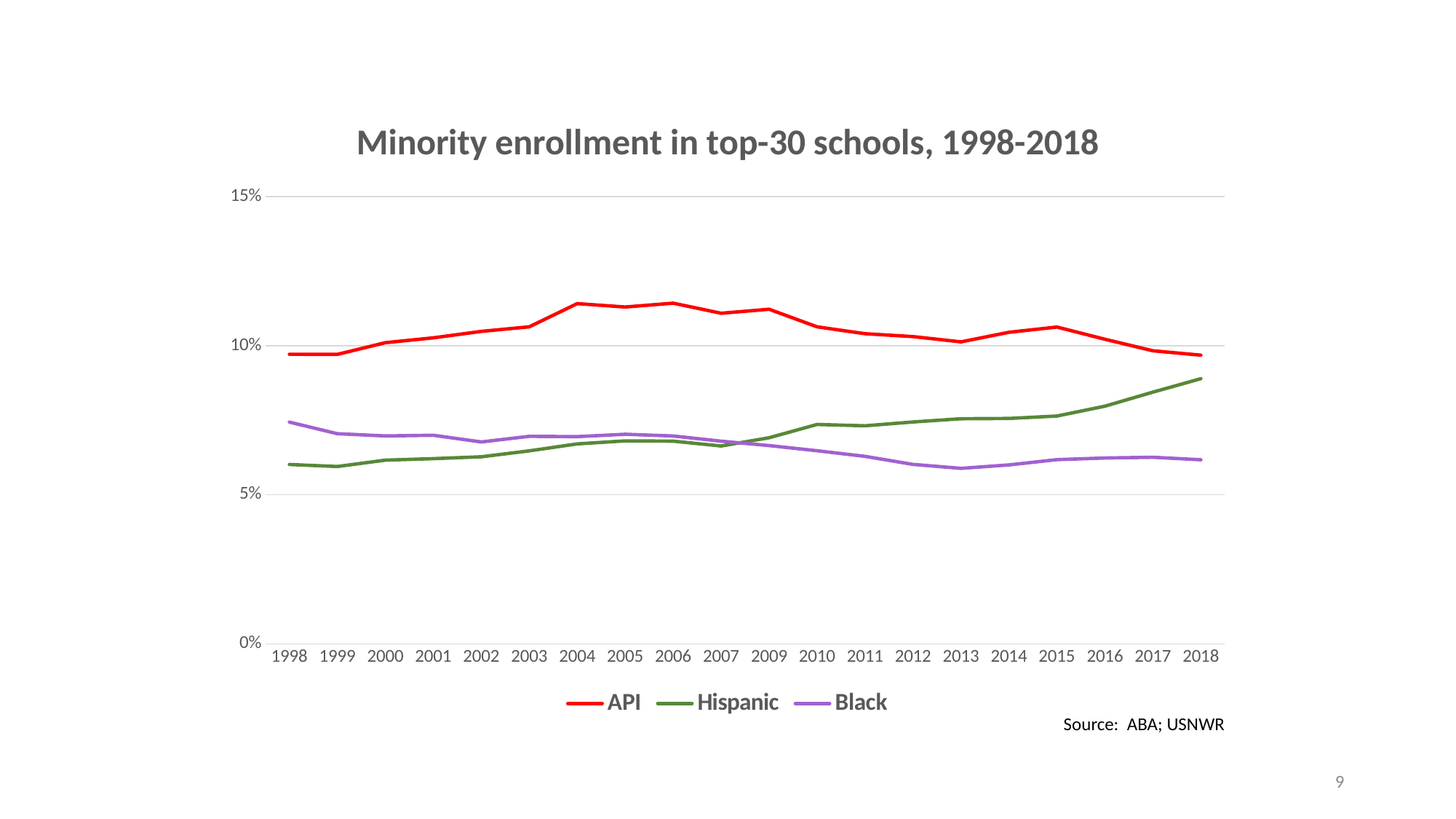
What kind of chart is shown on the slide? Line chart Is the value for API in 2004 greater or less than 10%? greater In 1998, which is larger, the value for Hispanic or the value for Black? Black What is the title of the chart? Minority enrollment in top-30 schools, 1998-2018 Does the Hispanic series rise or fall overall from 1998 to 2018? Rise Which series has the lowest value in 2018? Black How many years are shown on the x axis? 20 Is the value for Black in 2013 greater or less than 5%? greater Which series has the highest value in 2018? API Which series are listed in the legend? API, Hispanic, Black Is the value for Hispanic in 2018 greater or less than 10%? less How many series does the legend list? 3